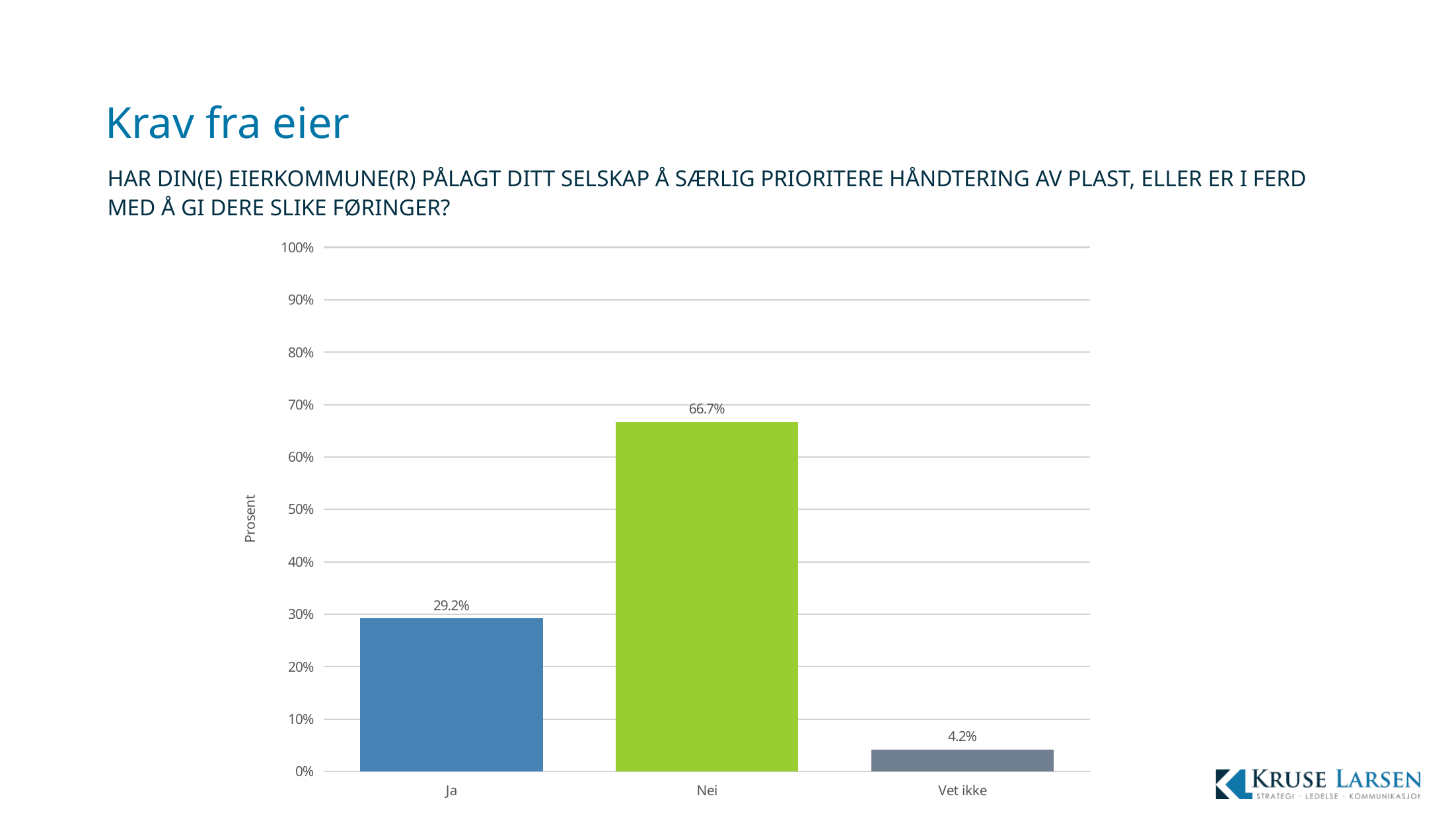
What is the difference between the values for Ja and Vet ikke? 25.0% What is the value for Ja? 29.2% Which is larger, the value for Ja or the value for Vet ikke? Ja What is the value for Vet ikke? 4.2% Which category has the highest value? Nei What kind of chart is shown on the slide? bar chart What is the label of the y axis? Prosent How many categories are shown on the x axis? 3 Which category has the lowest value? Vet ikke Is the value for Nei greater or less than 60%? greater What is the difference between the values for Nei and Ja? 37.5% What is the value for Nei? 66.7%